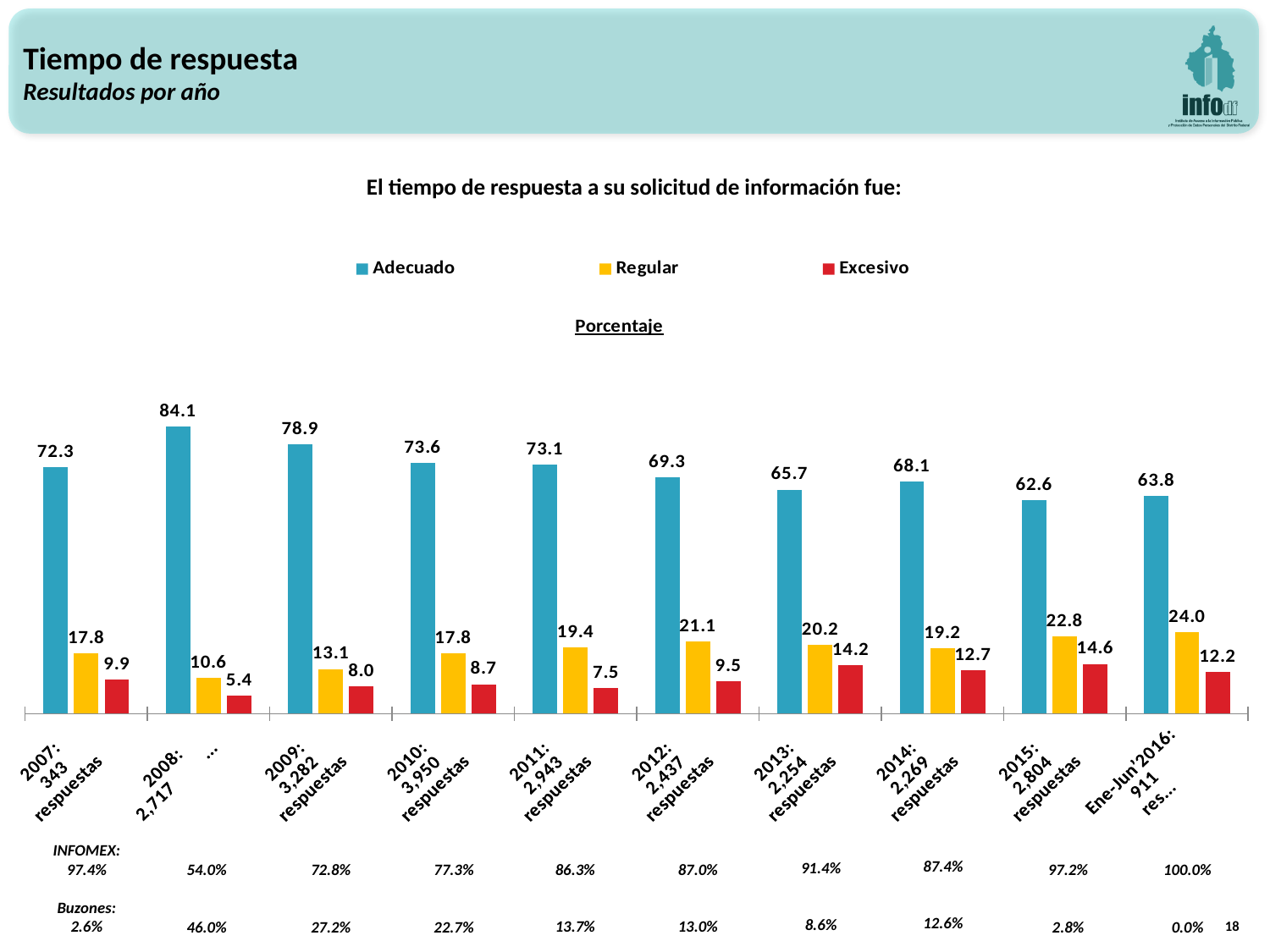
In which year is the Adecuado value highest? 2008 Does the Adecuado value rise or fall from 2008 to 2015? Fall What kind of chart is shown on the slide? Bar chart How many series does the legend list? 3 What is the Adecuado value for 2008? 84.1 Which is larger, the Regular value for 2015 or the Regular value for 2014? 2015 What is the Regular value for Ene-Jun 2016? 24.0 What is the Excesivo value for 2013? 14.2 How many year categories are shown on the x axis? 10 Which colour represents the Excesivo series in the legend? Red What is the difference between the Adecuado values for 2008 and 2015? 21.5 In which year is the Excesivo value lowest? 2008